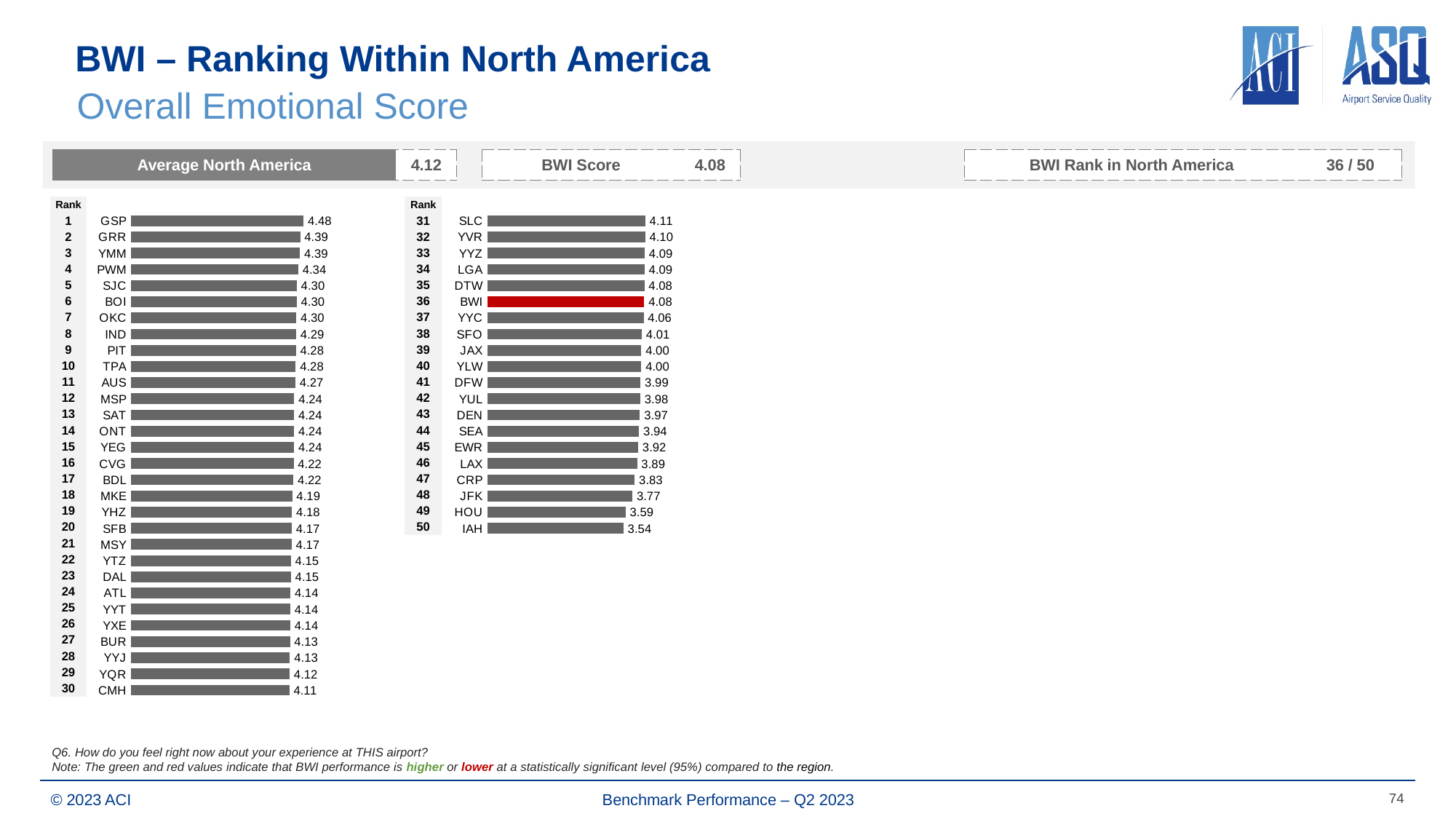
What kind of chart is used to show the airport rankings? Bar chart What is the Overall Emotional Score for BWI? 4.08 What is the Overall Emotional Score for IAH? 3.54 Which has a higher Overall Emotional Score, SFO or DEN? SFO Which airport has the highest Overall Emotional Score in the ranking? GSP What is the difference between the Overall Emotional Score of GSP and that of BWI? 0.40 Which airport has the lowest Overall Emotional Score in the ranking? IAH Which airport's bar is coloured red in the ranking chart? BWI What is BWI's rank in North America according to the slide? 36 / 50 What is the Average North America score shown on the slide? 4.12 How many airports are ranked in the chart? 50 What is the Overall Emotional Score for GSP? 4.48